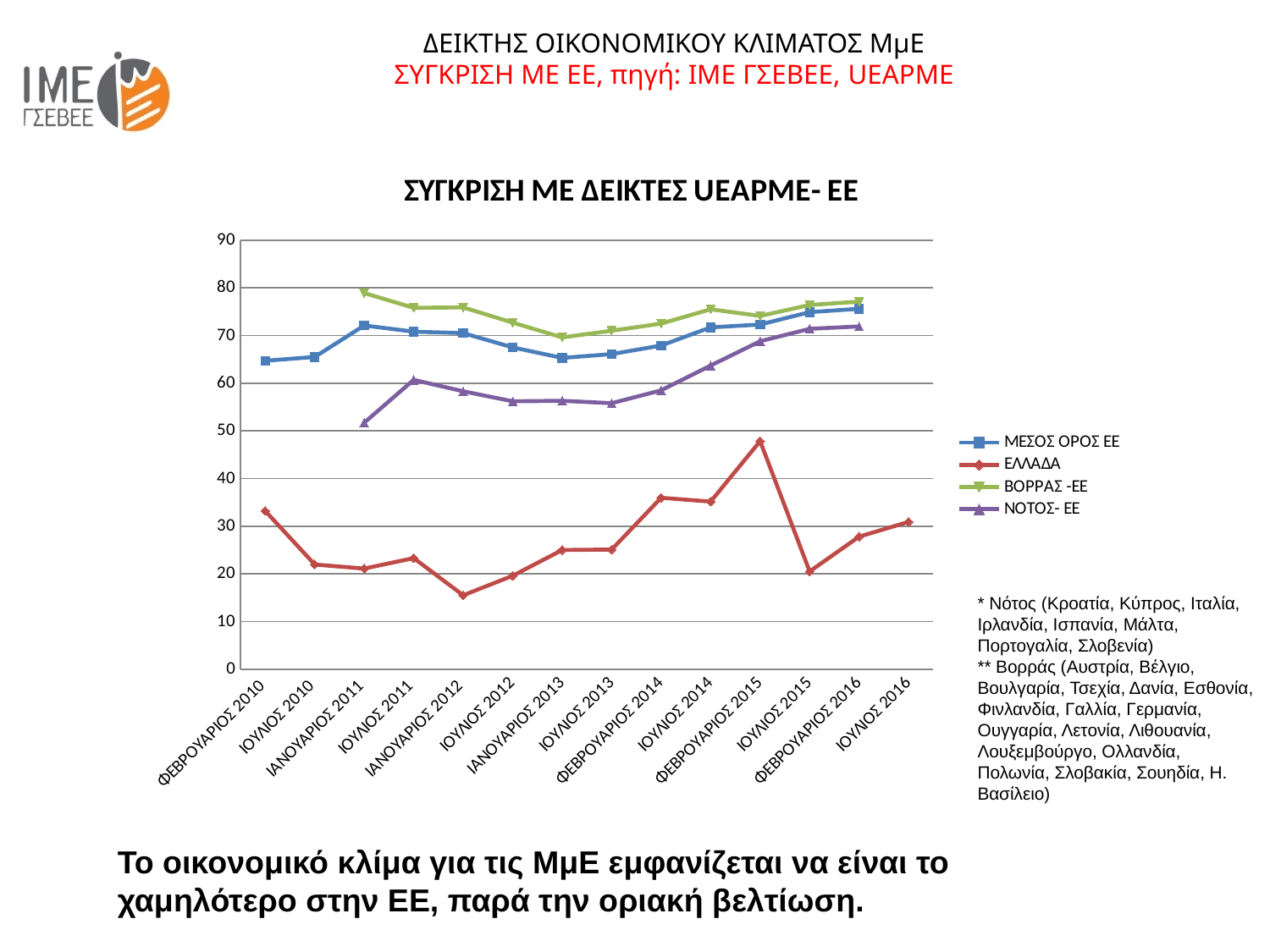
At which time point does the ΕΛΛΑΔΑ series reach its lowest value? ΙΑΝΟΥΑΡΙΟΣ 2012 What kind of chart is shown on the slide? Line chart Is the value for ΕΛΛΑΔΑ at ΦΕΒΡΟΥΑΡΙΟΣ 2015 greater or less than 40? greater Is the value for ΝΟΤΟΣ- ΕΕ at ΙΑΝΟΥΑΡΙΟΣ 2011 greater or less than 60? less How many series does the legend list? 4 At which time point does the ΕΛΛΑΔΑ series reach its highest value? ΦΕΒΡΟΥΑΡΙΟΣ 2015 Which series has the lowest values throughout the chart? ΕΛΛΑΔΑ Is the value for ΕΛΛΑΔΑ at ΙΑΝΟΥΑΡΙΟΣ 2012 greater or less than 20? less How many time points are shown on the x axis? 14